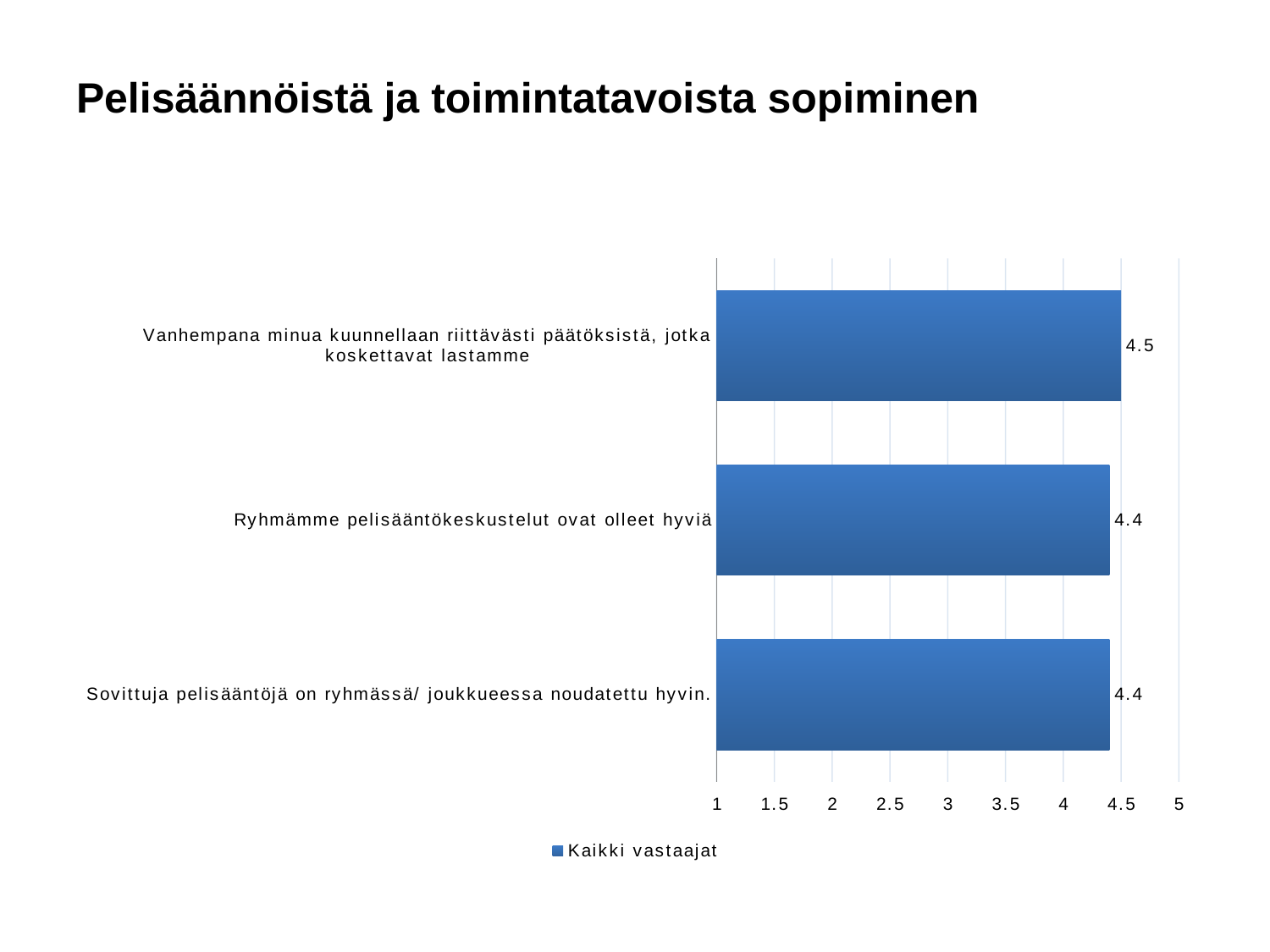
What is the name of the series listed in the legend? Kaikki vastaajat Is the value for "Ryhmämme pelisääntökeskustelut ovat olleet hyviä" greater or less than 4? greater Which category has the highest value? Vanhempana minua kuunnellaan riittävästi päätöksistä, jotka koskettavat lastamme What is the value for "Ryhmämme pelisääntökeskustelut ovat olleet hyviä"? 4.4 Is the value for "Vanhempana minua kuunnellaan riittävästi päätöksistä, jotka koskettavat lastamme" greater or less than 5? less How many categories are shown in the chart? 3 What is the value for "Sovittuja pelisääntöjä on ryhmässä/ joukkueessa noudatettu hyvin."? 4.4 What is the difference between the value for "Vanhempana minua kuunnellaan riittävästi päätöksistä, jotka koskettavat lastamme" and the value for "Ryhmämme pelisääntökeskustelut ovat olleet hyviä"? 0.1 What is the value for "Vanhempana minua kuunnellaan riittävästi päätöksistä, jotka koskettavat lastamme"? 4.5 How many series does the legend list? 1 What is the title of the slide? Pelisäännöistä ja toimintatavoista sopiminen What kind of chart is shown on the slide? bar chart